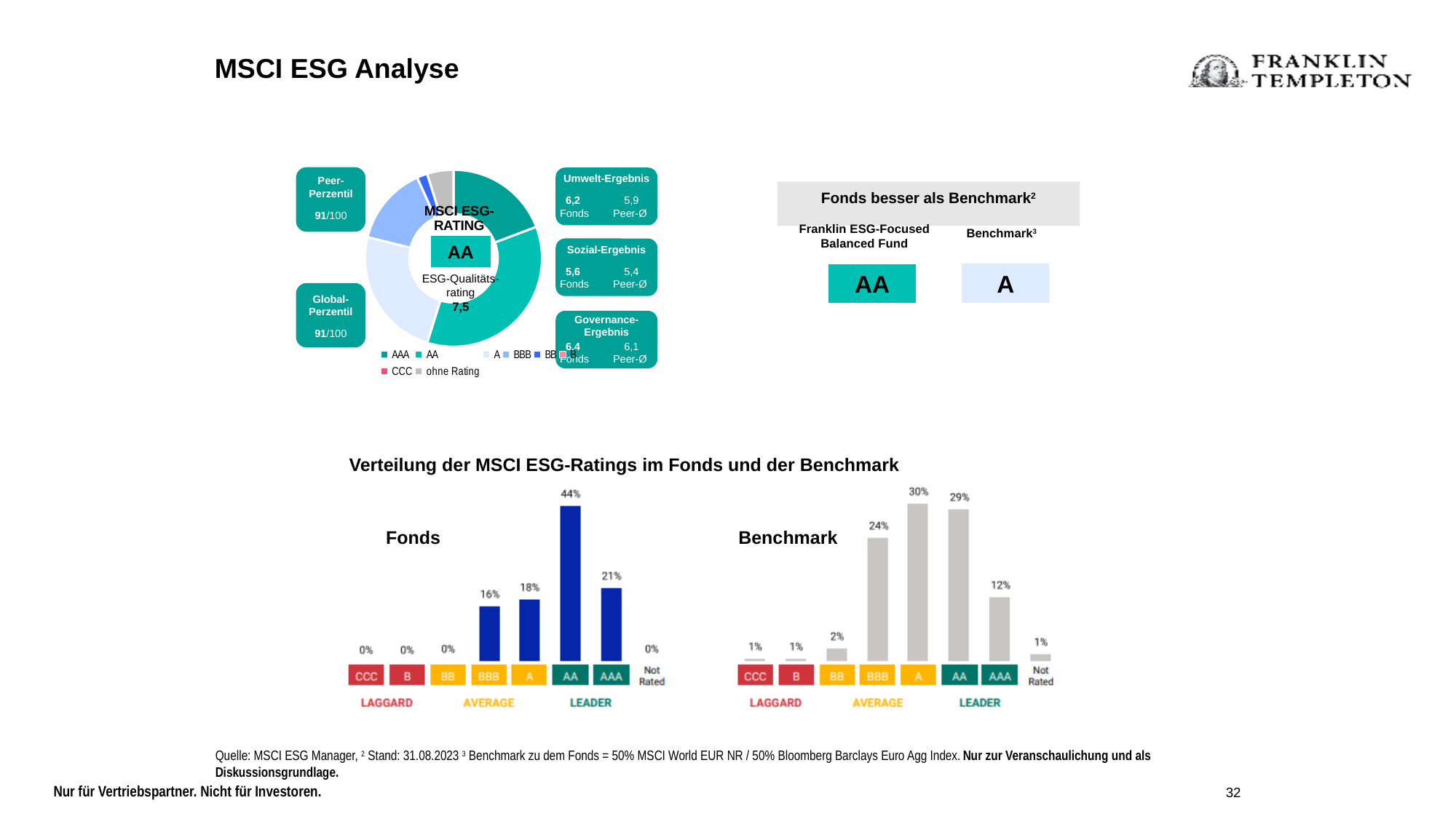
Which is larger: the value for AAA in the Fonds bar chart or the value for AAA in the Benchmark bar chart? Fonds In the Benchmark bar chart, which rating category has the highest value? A How many entries does the legend of the MSCI ESG-Rating donut chart list? 8 What kind of chart is the MSCI ESG-Rating chart at the top left of the slide? Donut chart How many rating categories are shown on the x axis of the Fonds bar chart? 8 In the Benchmark bar chart, what is the difference between the values for BBB and AAA? 12% In the Fonds bar chart, what is the value for AA? 44% In the Benchmark bar chart, what is the value for AAA? 12% In the Fonds bar chart, what is the value for BBB? 16% In the Fonds bar chart, what is the difference between the values for AA and AAA? 23% In the Benchmark bar chart, what is the value for A? 30% In the Fonds bar chart, which rating category has the highest value? AA